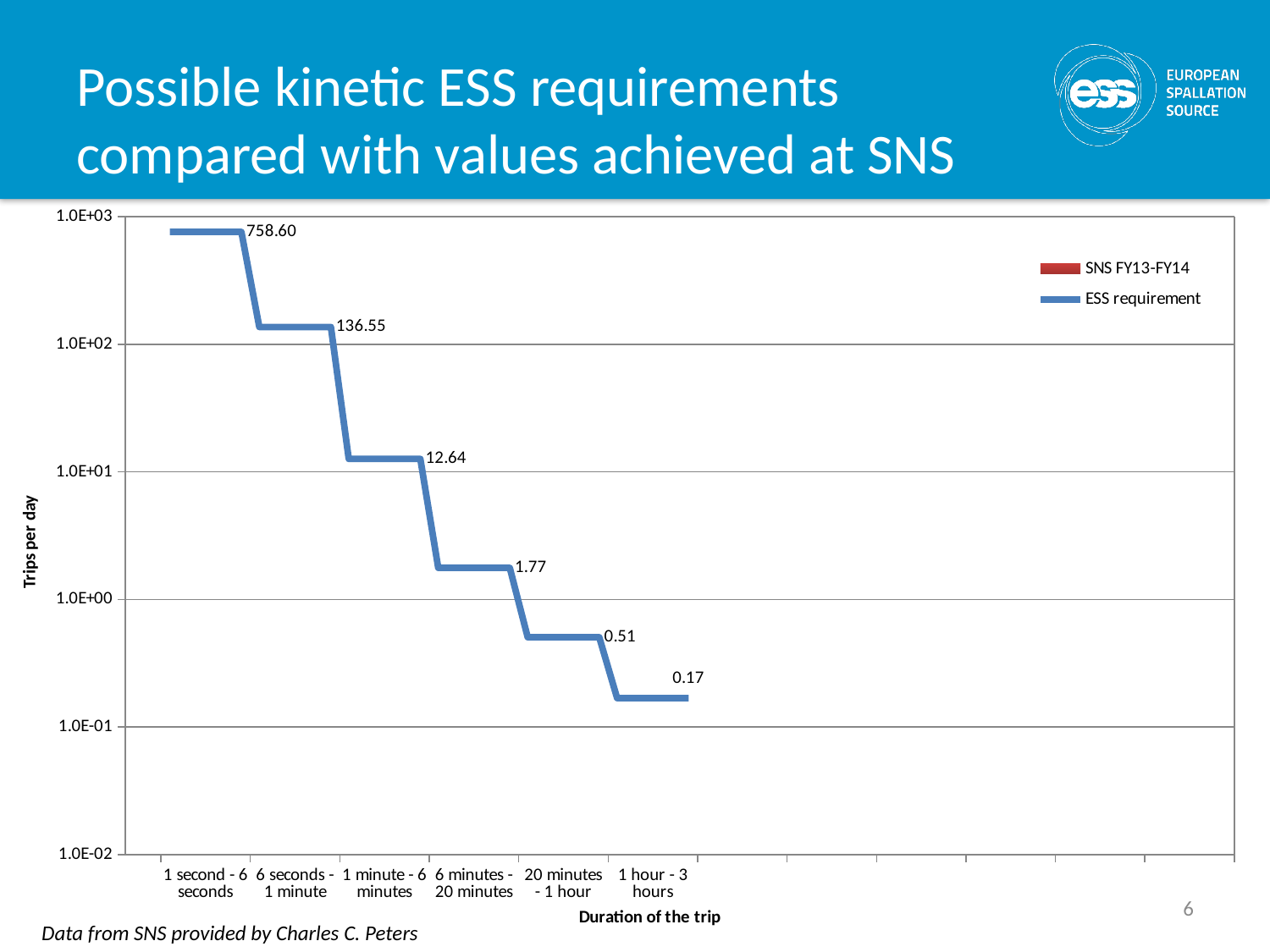
What value is labelled for the '20 minutes - 1 hour' trip duration? 0.51 How many series does the legend list? 2 What is the title of the y axis? Trips per day Which trip duration category has the highest value of trips per day? 1 second - 6 seconds What is the difference between the values for '1 second - 6 seconds' and '6 seconds - 1 minute'? 622.05 What value is labelled for the '1 second - 6 seconds' trip duration? 758.60 What value is labelled for the '1 hour - 3 hours' trip duration? 0.17 Which trip duration category has the lowest value of trips per day? 1 hour - 3 hours What value is labelled for the '1 minute - 6 minutes' trip duration? 12.64 Do the values rise or fall as the trip duration increases along the x axis? fall What value is labelled for the '6 seconds - 1 minute' trip duration? 136.55 How many trip duration categories are labelled on the x axis? 6